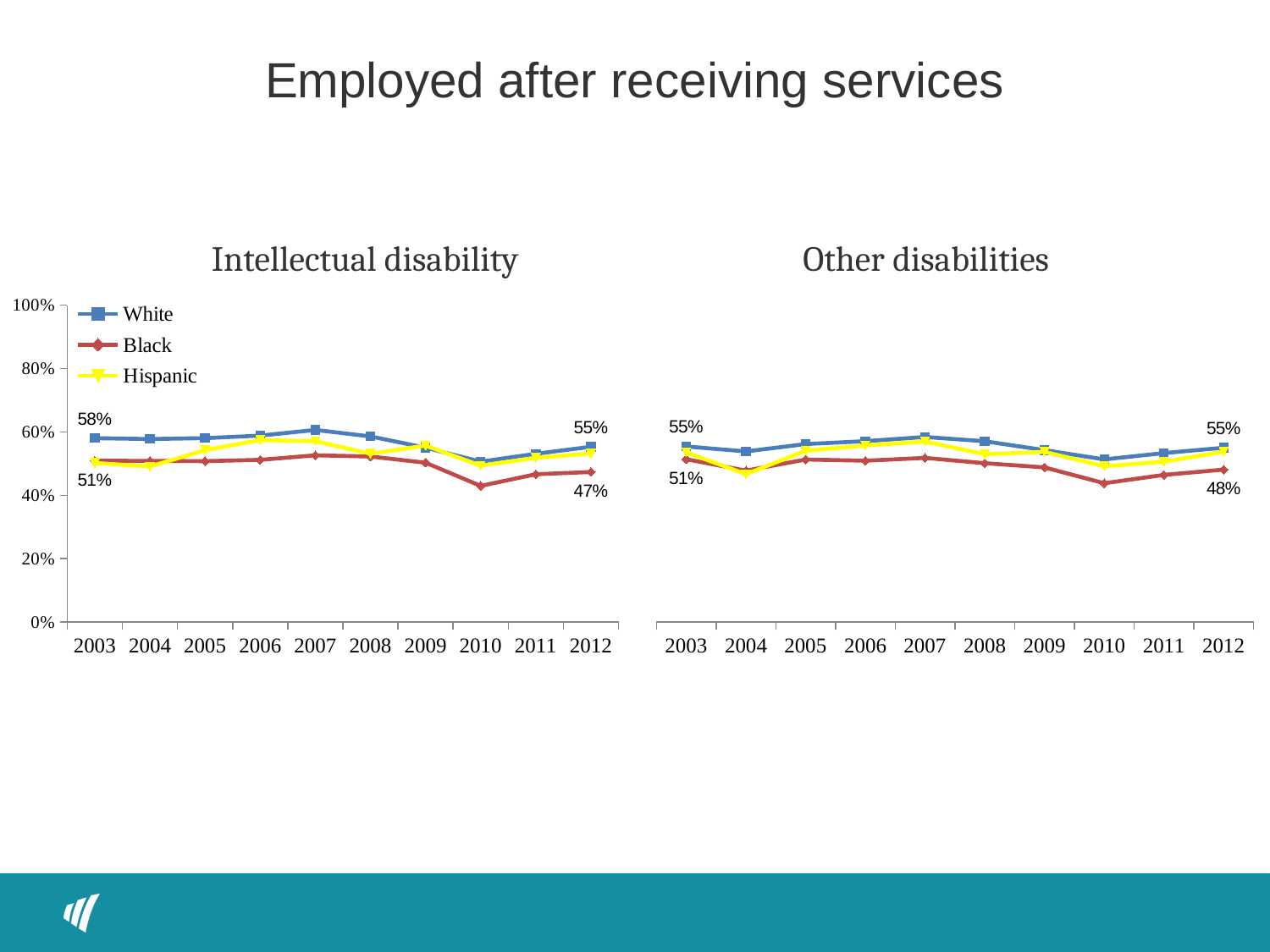
How many series does the legend of the Intellectual disability chart list? 3 In the Intellectual disability chart, is the value for Black in 2010 greater or less than 60%? less In the Intellectual disability chart, what is the difference between the White and Black values in 2012? 8% In the Other disabilities chart, what is the value for Black in 2003? 51% In the Intellectual disability chart, which is larger in 2003, the White value or the Black value? White In the Intellectual disability chart, what is the value for White in 2003? 58% How many years are shown on the x axis of the Other disabilities chart? 10 In the Other disabilities chart, what is the difference between the White and Black values in 2012? 7% In the Other disabilities chart, what is the value for White in 2012? 55% What is the title of the slide? Employed after receiving services In the Intellectual disability chart, what is the value for Black in 2012? 47% What kind of chart is the Other disabilities chart? line chart